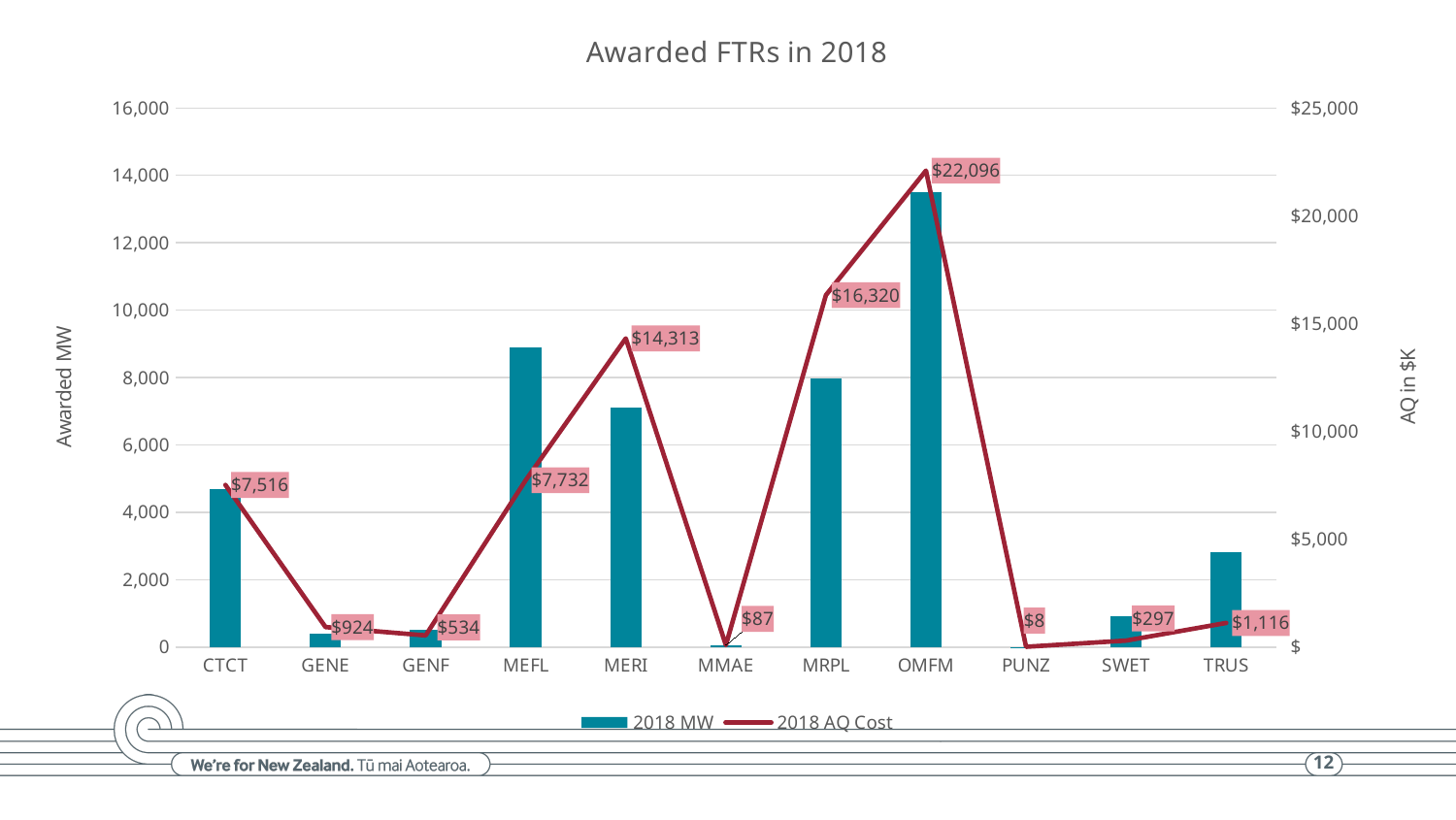
What is the 2018 AQ Cost for OMFM? $22,096 Which category has the highest 2018 AQ Cost? OMFM What is the title of the chart? Awarded FTRs in 2018 Is the 2018 MW value for OMFM greater or less than 12,000? greater Is the 2018 MW value for TRUS greater or less than 4,000? less What is the 2018 AQ Cost for MERI? $14,313 How many series does the legend list? 2 What is the 2018 AQ Cost for GENF? $534 What is the difference between the 2018 AQ Cost for OMFM and MRPL? $5,776 How many categories are shown on the x axis? 11 Which has a larger 2018 AQ Cost, CTCT or MEFL? MEFL Which category has the lowest 2018 AQ Cost? PUNZ